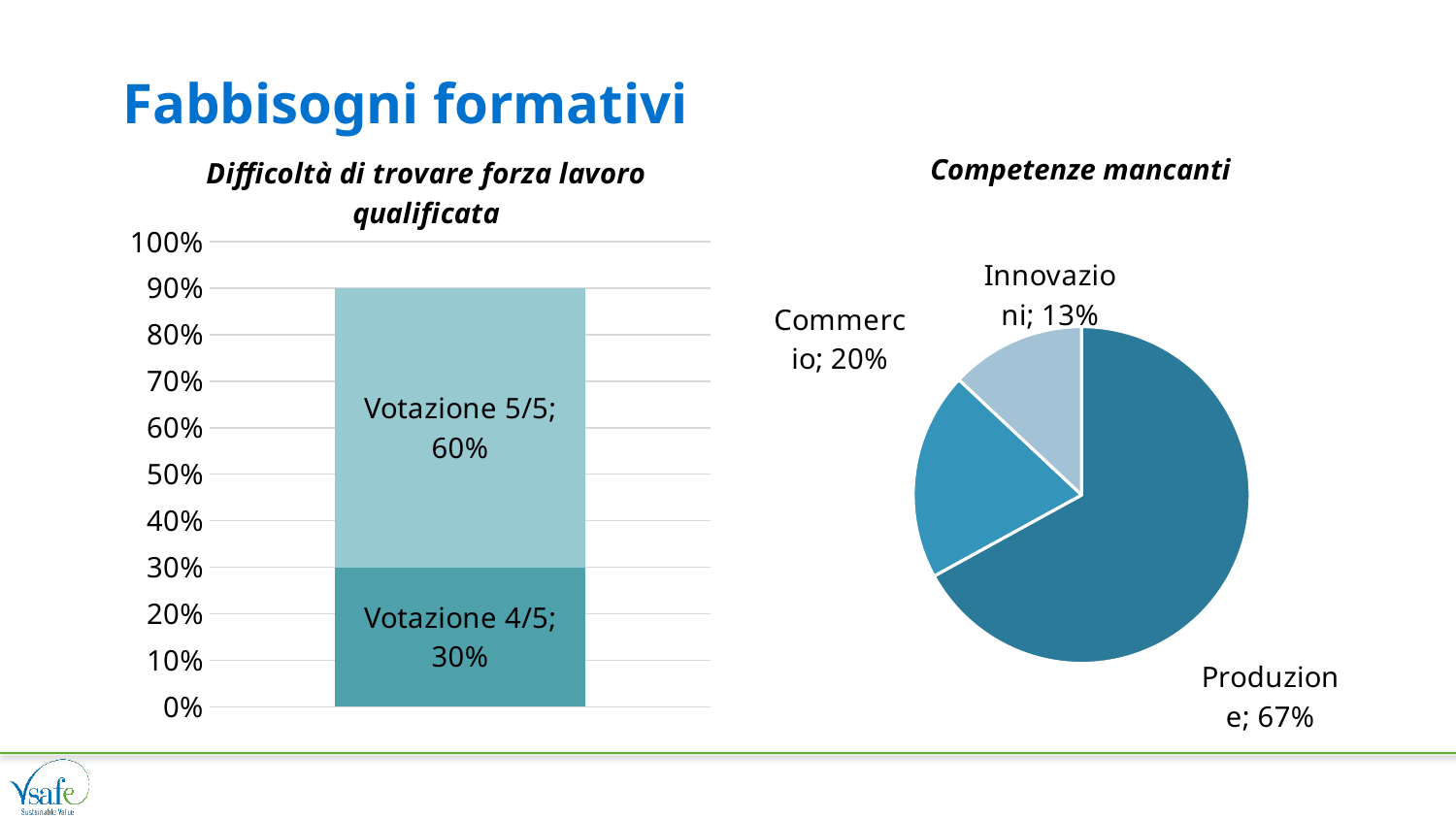
In the chart 'Difficoltà di trovare forza lavoro qualificata', what is the value for Votazione 4/5? 30% In the chart 'Difficoltà di trovare forza lavoro qualificata', what is the total of the stacked bar? 90% In the chart 'Competenze mancanti', what is the share for Innovazioni? 13% In the chart 'Difficoltà di trovare forza lavoro qualificata', which segment is larger, Votazione 5/5 or Votazione 4/5? Votazione 5/5 In the chart 'Competenze mancanti', which category has the smallest slice? Innovazioni What kind of chart is 'Competenze mancanti'? Pie chart What kind of chart is 'Difficoltà di trovare forza lavoro qualificata'? Stacked bar chart In the chart 'Difficoltà di trovare forza lavoro qualificata', what is the difference between Votazione 5/5 and Votazione 4/5? 30% In the chart 'Difficoltà di trovare forza lavoro qualificata', what is the value for Votazione 5/5? 60% In the chart 'Competenze mancanti', how many slices does the pie have? 3 In the chart 'Competenze mancanti', what is the share for Produzione? 67% In the chart 'Competenze mancanti', what is the share for Commercio? 20%